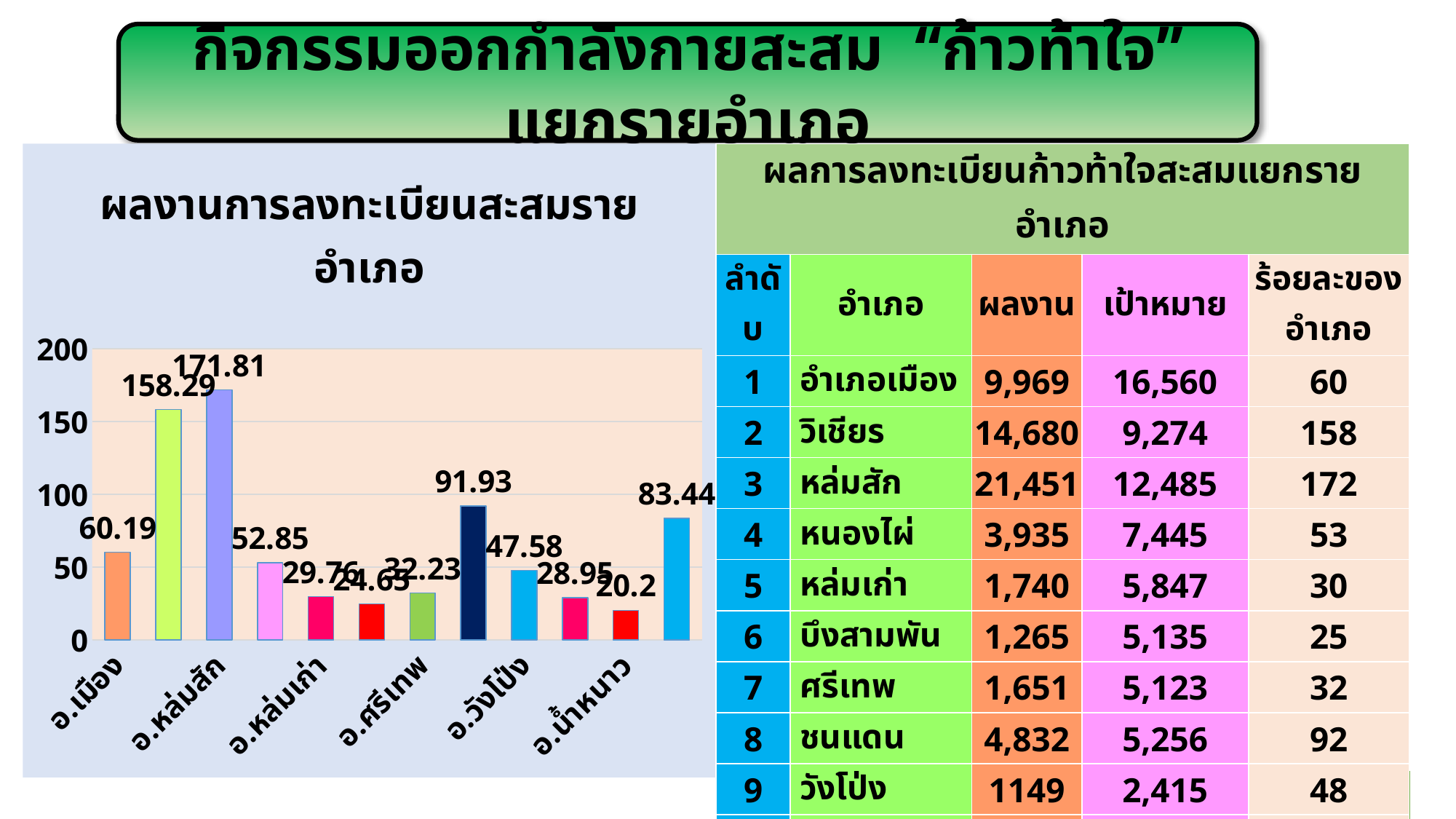
Which labelled category has the highest value in the chart? อ.หล่มสัก What is the value for อ.น้ำหนาว in the chart? 20.2 Which is larger, the value for อ.เมือง or the value for อ.วังโป่ง? อ.เมือง What is the value for อ.วังโป่ง in the chart? 47.58 What is the difference between the values for อ.หล่มสัก and อ.เมือง? 111.62 What type of chart is shown on the slide? bar chart How many bars are plotted in the chart? 12 Which labelled category has the lowest value in the chart? อ.น้ำหนาว What is the value for อ.เมือง in the chart? 60.19 What is the title of the chart? ผลงานการลงทะเบียนสะสมรายอำเภอ What is the value for อ.หล่มสัก in the chart? 171.81 What is the value for อ.หล่มเก่า in the chart? 29.76